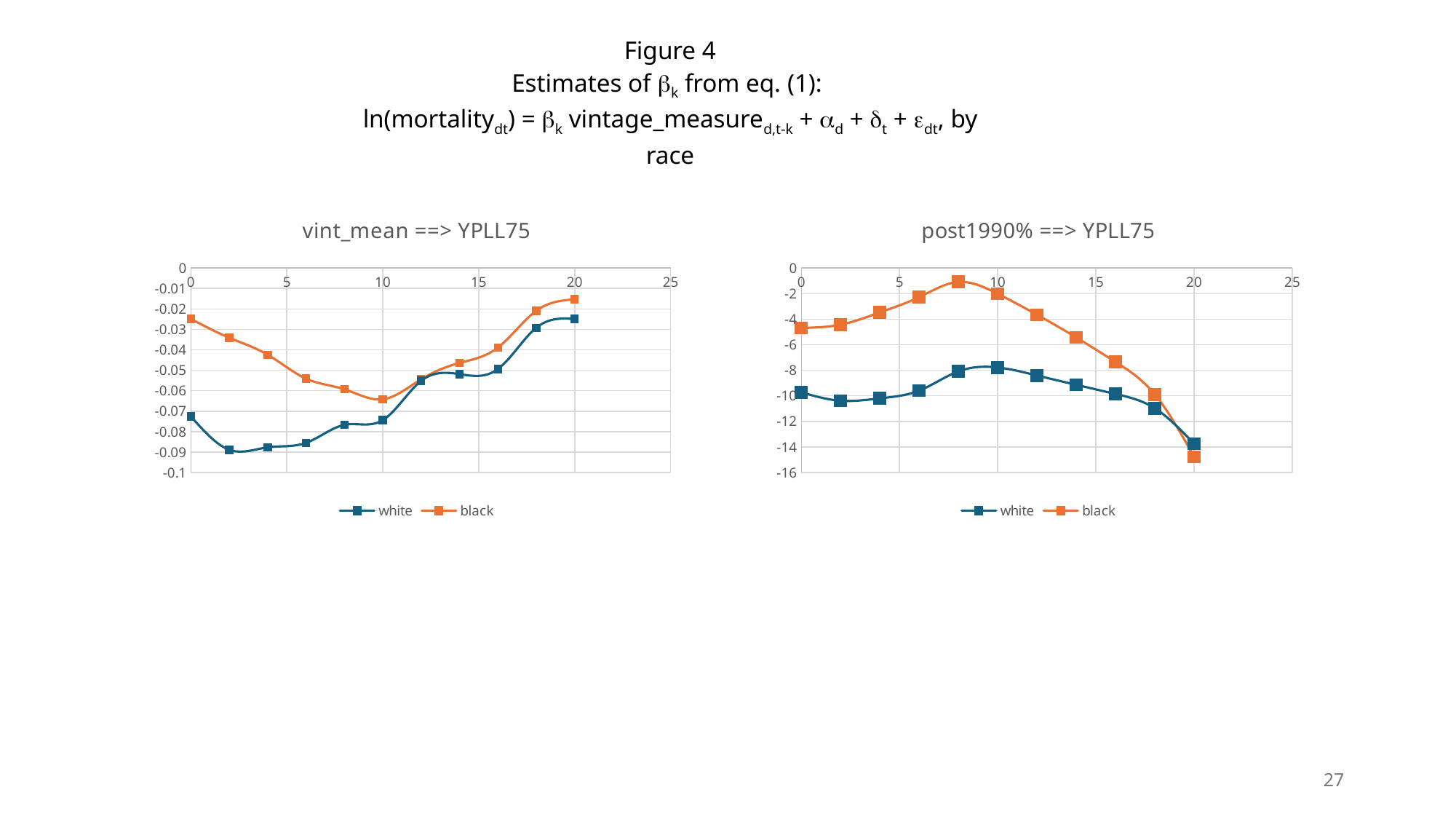
In the right chart "post1990% ==> YPLL75", which series has the higher value at x = 10, white or black? black In the left chart "vint_mean ==> YPLL75", is the value for the black series at x = 0 greater or less than -0.03? greater What is the title of the right chart on the slide? post1990% ==> YPLL75 In the right chart "post1990% ==> YPLL75", at which x value does the black series reach its highest point? 8 In the left chart "vint_mean ==> YPLL75", which series has the higher value at x = 4, white or black? black In the right chart "post1990% ==> YPLL75", is the value for the white series at x = 20 greater or less than -12? less How many series does the legend of the right chart "post1990% ==> YPLL75" list? 2 In the left chart "vint_mean ==> YPLL75", is the value for the white series at x = 2 greater or less than -0.08? less In the right chart "post1990% ==> YPLL75", do the values of the black series rise or fall between x = 10 and x = 20? fall What kind of chart is the left chart titled "vint_mean ==> YPLL75"? line chart In the left chart "vint_mean ==> YPLL75", how many data points are plotted for the white series? 11